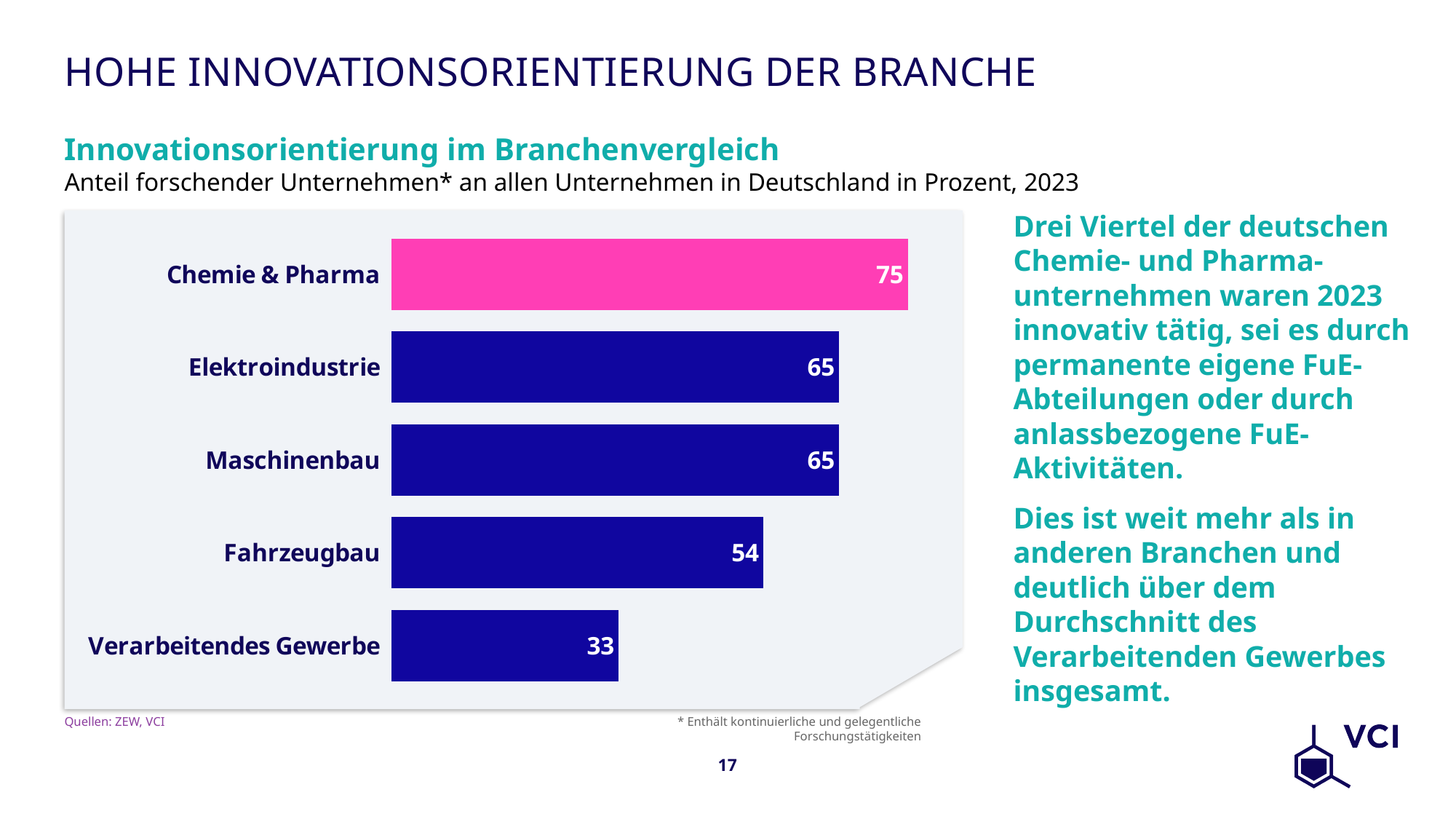
What is the difference between the values for Maschinenbau and Fahrzeugbau? 11 Which category has the lowest value? Verarbeitendes Gewerbe Which category has the highest value? Chemie & Pharma What is the value for Elektroindustrie? 65 What is the value for Chemie & Pharma? 75 What is the value for Fahrzeugbau? 54 How many categories are shown in the chart? 5 Which category's bar is coloured pink rather than dark blue? Chemie & Pharma What is the value for Verarbeitendes Gewerbe? 33 Which is larger, the value for Fahrzeugbau or the value for Maschinenbau? Maschinenbau What kind of chart is shown on the slide? Bar chart What is the difference between the values for Chemie & Pharma and Verarbeitendes Gewerbe? 42